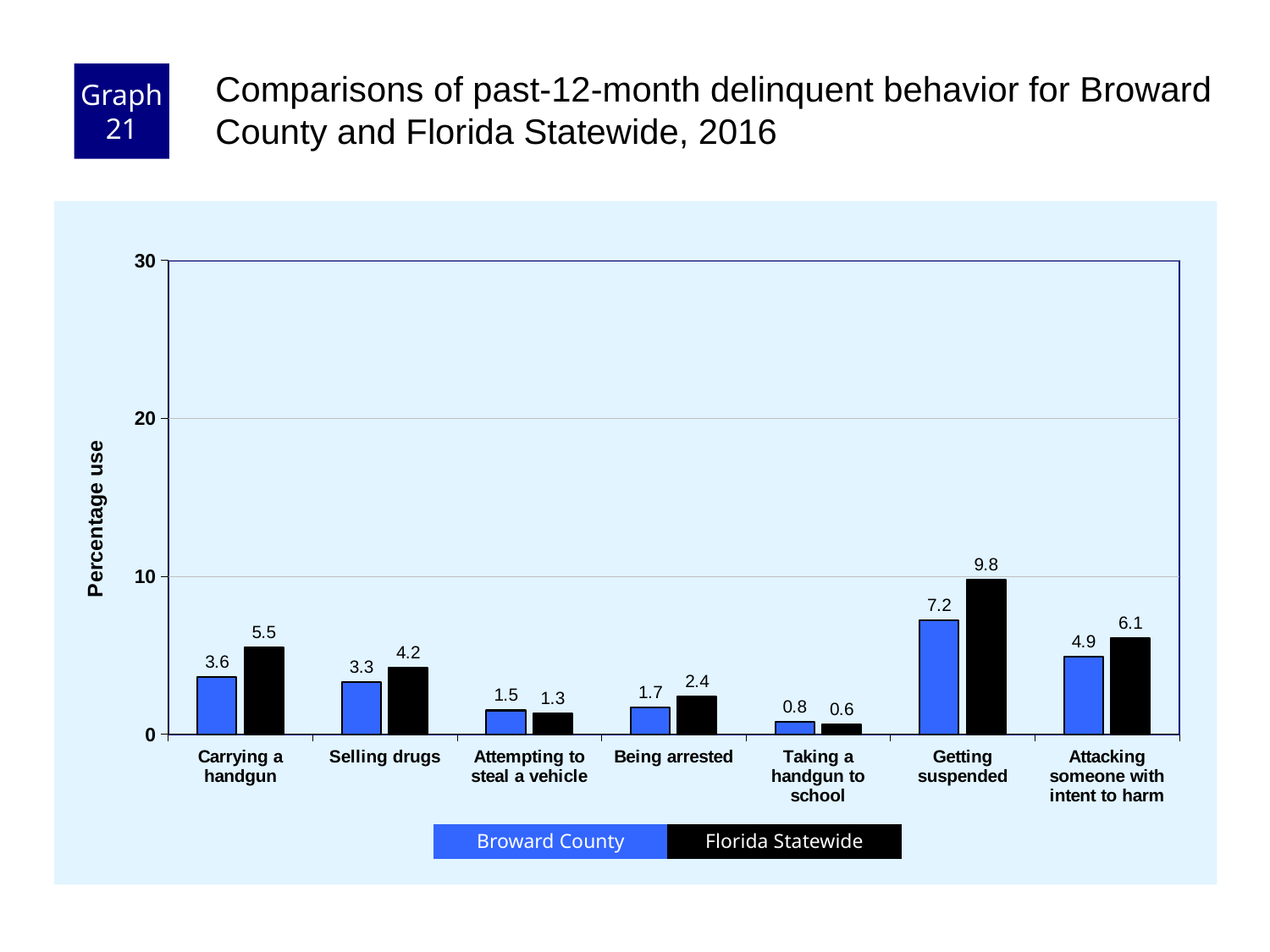
How many behavior categories are shown on the x axis? 7 What is the Broward County value for Getting suspended? 7.2 What is the label of the y axis? Percentage use Which category has the lowest Broward County value? Taking a handgun to school What is the difference between the Florida Statewide and Broward County values for Getting suspended? 2.6 What kind of chart is shown on the slide? Bar chart What is the Florida Statewide value for Carrying a handgun? 5.5 Which is larger for Attempting to steal a vehicle: Broward County or Florida Statewide? Broward County What is the Broward County value for Taking a handgun to school? 0.8 Is the Florida Statewide value for Getting suspended greater or less than 10? less How many series does the legend list? 2 Which category has the highest Florida Statewide value? Getting suspended